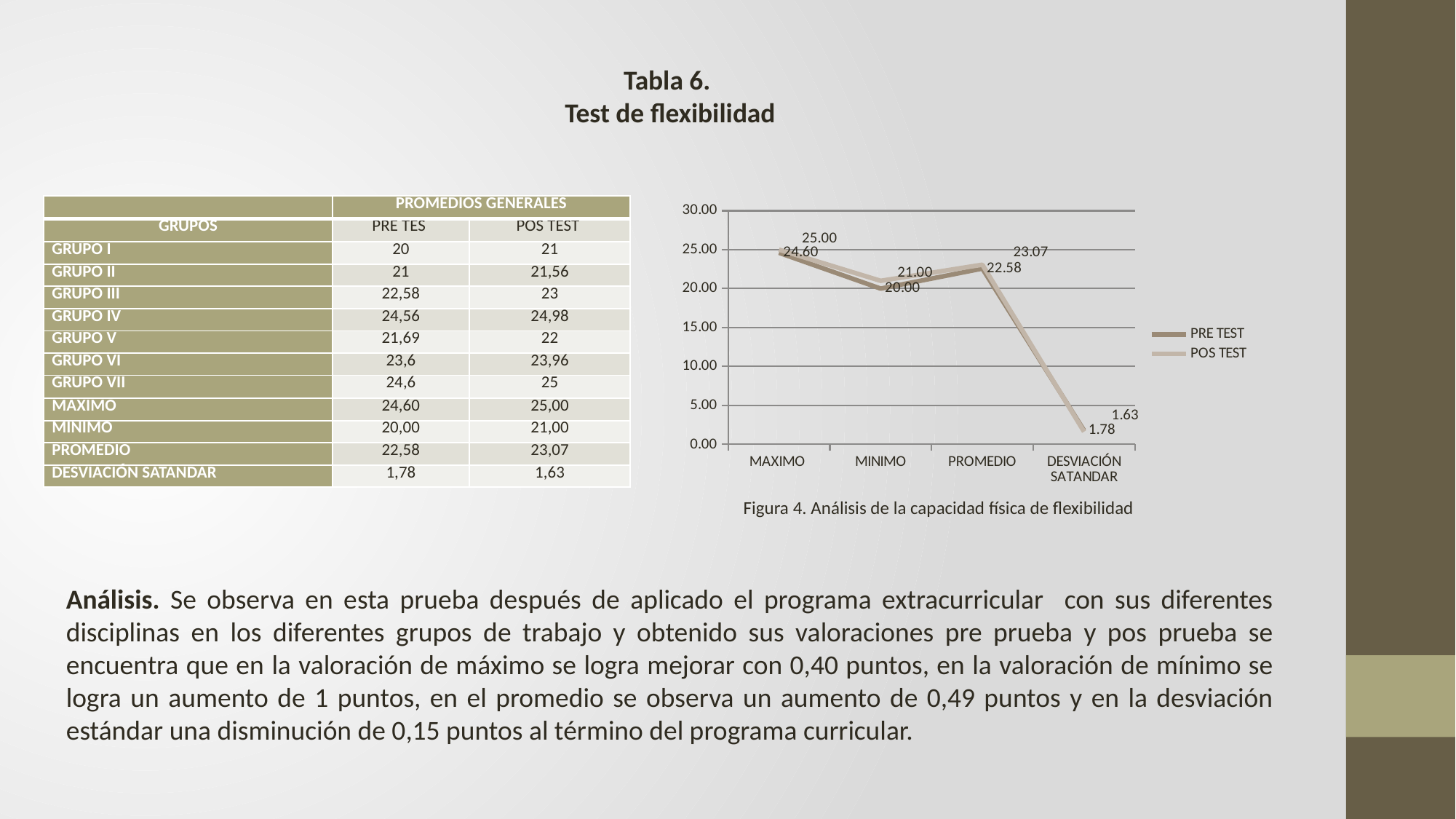
What is the POS TEST value for MINIMO in the chart? 21.00 What is the PRE TEST value for MAXIMO in the chart? 24.60 Which category has the lowest POS TEST value in the chart? DESVIACIÓN SATANDAR Which category has the highest PRE TEST value in the chart? MAXIMO What is the PRE TEST value for DESVIACIÓN SATANDAR in the chart? 1.78 What is the POS TEST value for PROMEDIO in the chart? 23.07 What is the difference between the POS TEST and PRE TEST values for MINIMO in the chart? 1.00 For DESVIACIÓN SATANDAR, which series has the larger value in the chart, PRE TEST or POS TEST? PRE TEST Is the PRE TEST value for PROMEDIO greater or less than 20.00? greater What type of chart is shown in Figura 4? Line chart How many categories are shown on the x axis of the chart? 4 How many series does the chart legend list? 2